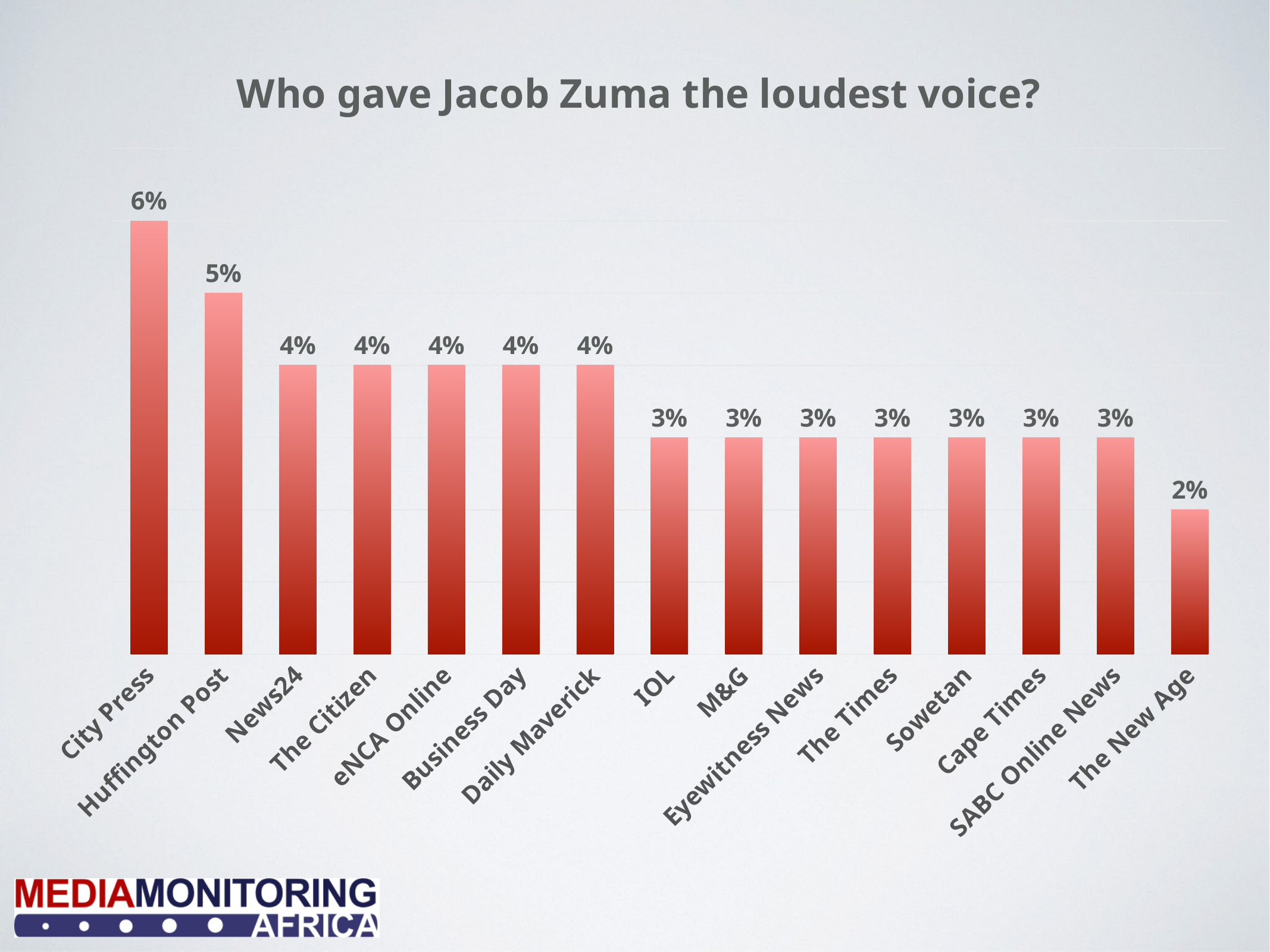
What is the value for City Press? 6% What is the difference between the values for City Press and The New Age? 4% Which category has the highest value? City Press What is the value for The New Age? 2% What is the difference between the values for Huffington Post and IOL? 2% What kind of chart is shown on the slide? Bar chart Which category has the lowest value? The New Age What is the value for Daily Maverick? 4% What is the value for Huffington Post? 5% How many categories are shown in the chart? 15 Which is larger, the value for News24 or the value for Cape Times? News24 What is the value for Sowetan? 3%